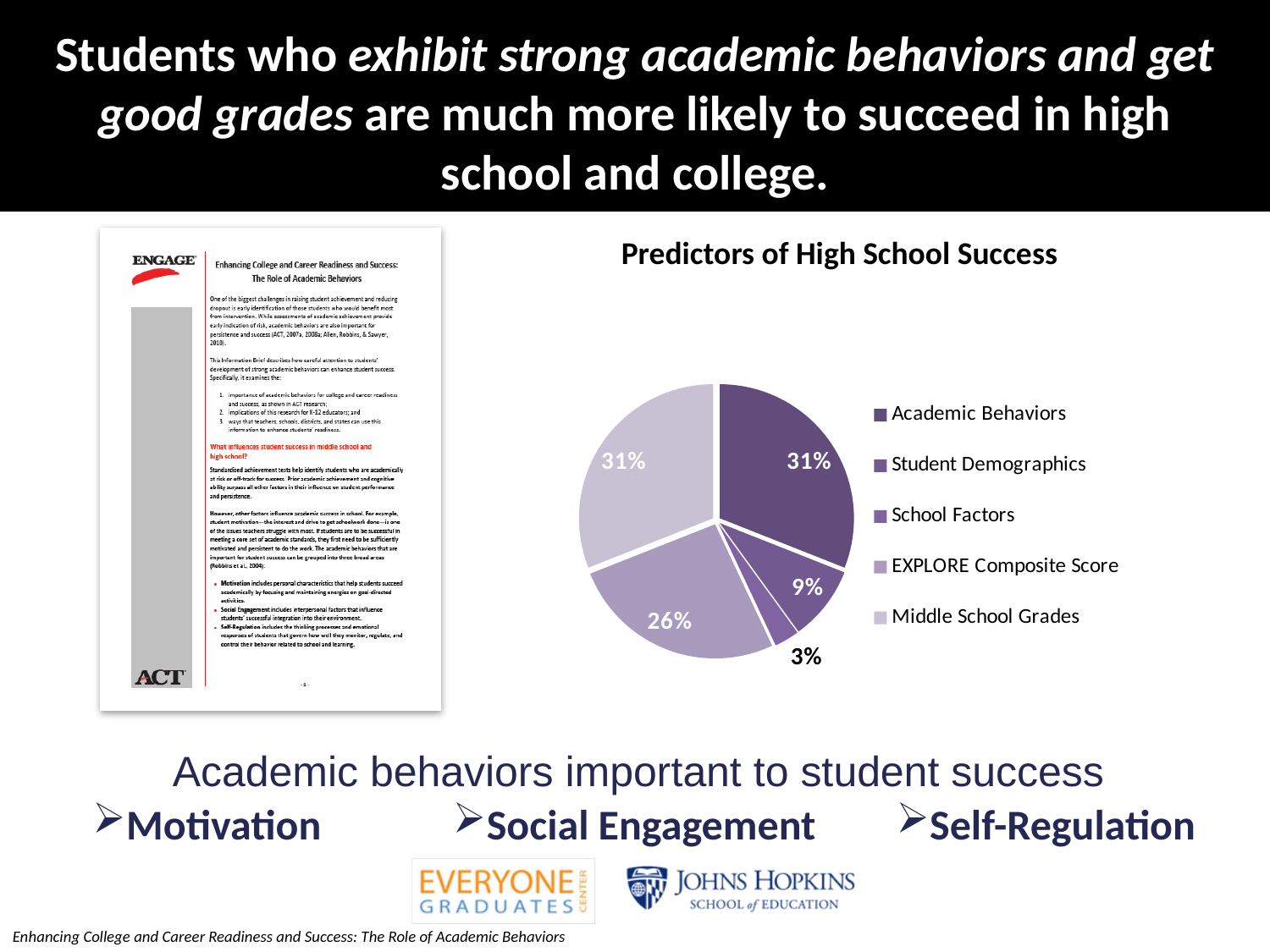
How many slices does the pie chart have? 5 Which predictor has the smallest slice of the pie? School Factors What is the title of the pie chart? Predictors of High School Success What percentage is shown for Middle School Grades? 31% What kind of chart is shown under the title "Predictors of High School Success"? pie chart What percentage is shown for Student Demographics? 9% What percentage of the pie is labelled for Academic Behaviors? 31% What percentage is shown for EXPLORE Composite Score? 26% What percentage is shown for School Factors? 3% How many entries are listed in the pie chart's legend? 5 Which slice is larger, EXPLORE Composite Score or Student Demographics? EXPLORE Composite Score How many percentage points larger is the Academic Behaviors slice than the Student Demographics slice? 22